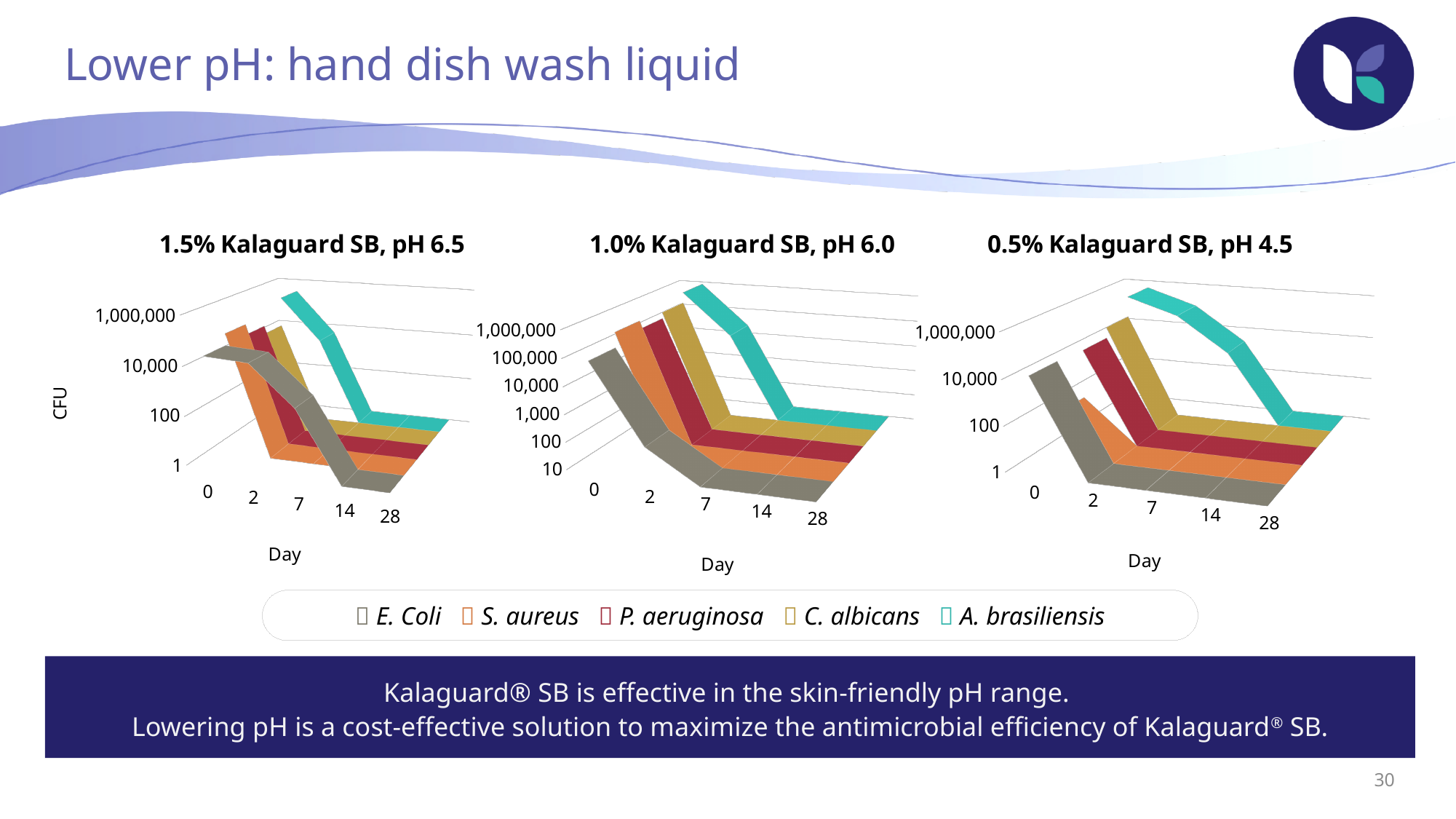
In the '1.0% Kalaguard SB, pH 6.0' chart, is the A. brasiliensis value at day 0 greater or less than 100,000? greater What kind of chart is the '1.0% Kalaguard SB, pH 6.0' chart? line chart In the '1.0% Kalaguard SB, pH 6.0' chart, do the E. Coli values rise or fall from day 0 to day 7? fall In the '0.5% Kalaguard SB, pH 4.5' chart, do the A. brasiliensis values rise or fall from day 0 to day 28? fall What is the title of the leftmost chart? 1.5% Kalaguard SB, pH 6.5 In the '0.5% Kalaguard SB, pH 4.5' chart, is the E. Coli value at day 28 greater or less than 100? less In the '1.0% Kalaguard SB, pH 6.0' chart, which is larger at day 2: the A. brasiliensis value or the E. Coli value? A. brasiliensis In the '1.5% Kalaguard SB, pH 6.5' chart, which series has the highest value at day 7? E. Coli How many charts are shown on the slide? 3 In the '1.5% Kalaguard SB, pH 6.5' chart, how many day points are plotted along the x axis? 5 How many series does the legend list for the charts? 5 Which series is drawn in teal in the charts? A. brasiliensis